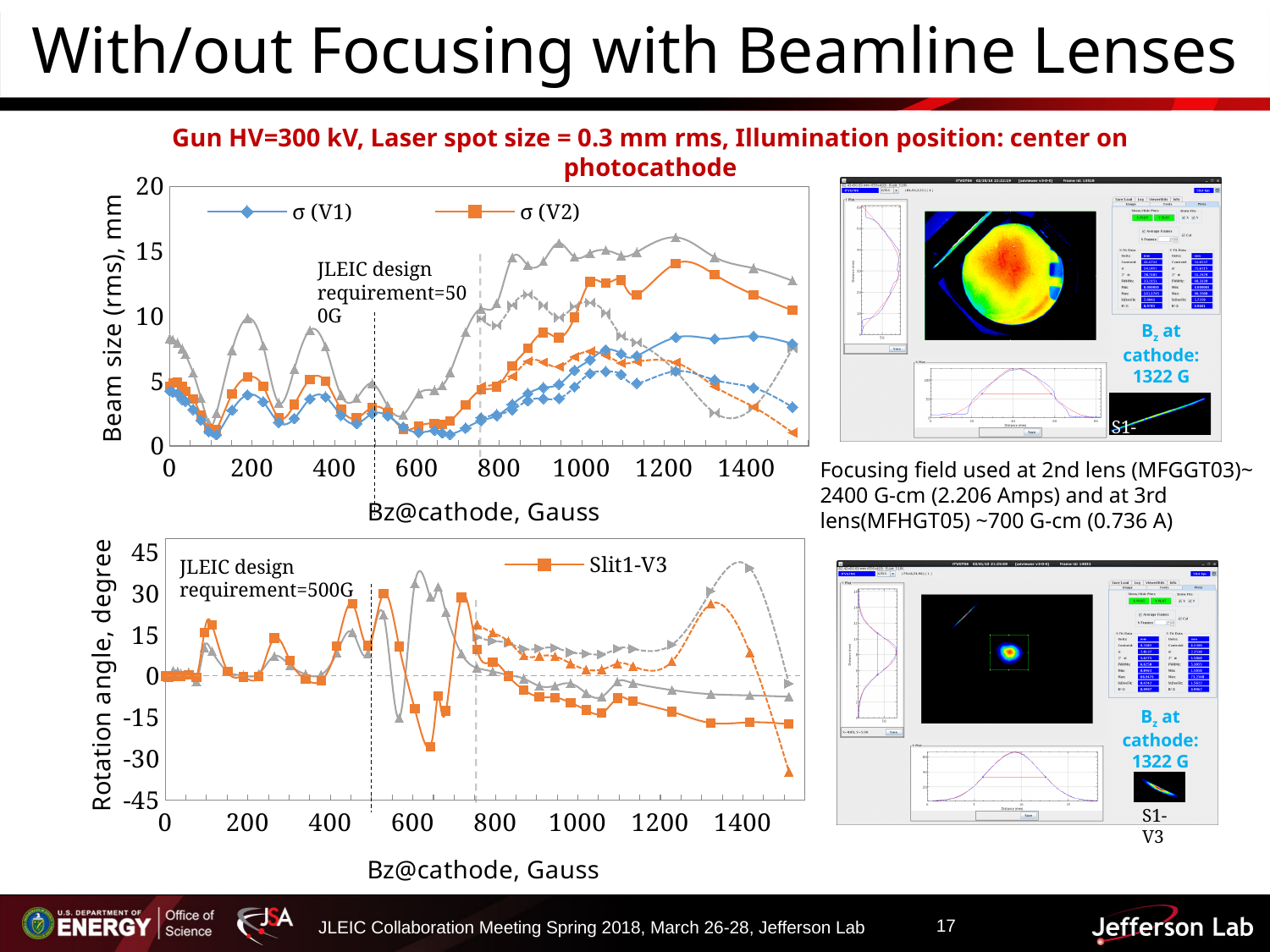
In the top chart (Beam size), is the value of σ (V2) at 1200 Gauss greater or less than 10? greater In the top chart (Beam size), is the value of σ (V1) at 1200 Gauss greater or less than 10? less In the bottom chart (Rotation angle), is the value of Slit1-V3 at 1400 Gauss greater or less than 0? less In the top chart (Beam size), does σ (V1) rise or fall between 0 and 100 Gauss? fall In the top chart (Beam size), which series has the larger value at 1200 Gauss, σ (V1) or σ (V2)? σ (V2) What is the name of the series in the legend of the bottom chart (Rotation angle)? Slit1-V3 What kind of chart is the top chart (Beam size vs Bz@cathode)? line chart How many series does the legend of the top chart (Beam size) list? 2 What is the y-axis title of the top chart? Beam size (rms), mm How many series does the legend of the bottom chart (Rotation angle) list? 1